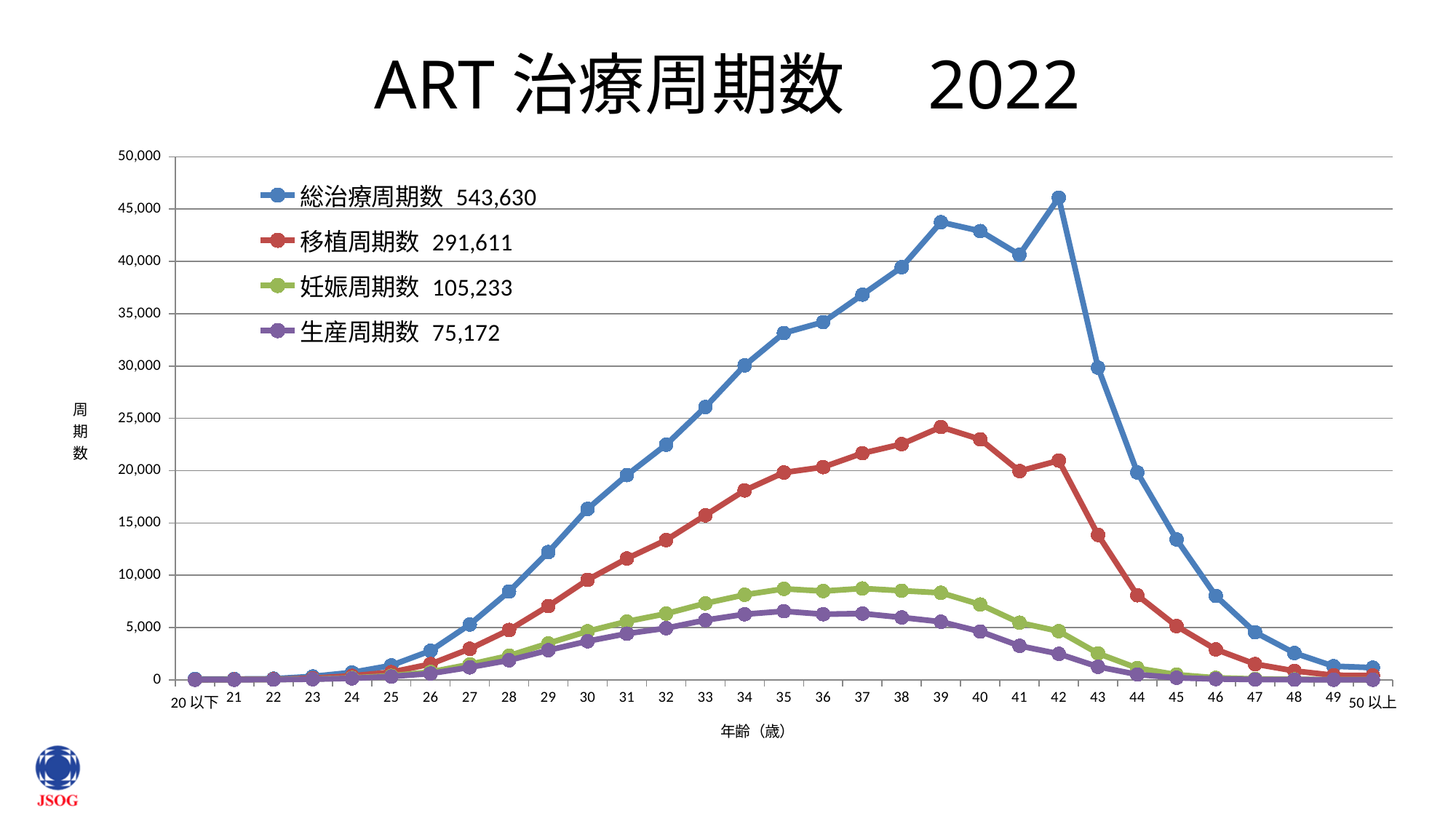
What total is shown in the legend for 生産周期数? 75,172 At which age does the 移植周期数 series reach its highest value? 39 What total is shown in the legend for 妊娠周期数? 105,233 At which age does the 総治療周期数 series reach its highest value? 42 How many series does the legend list? 4 Which series is larger at age 35, 総治療周期数 or 移植周期数? 総治療周期数 What total is shown in the legend for 移植周期数? 291,611 What total is shown in the legend for 総治療周期数? 543,630 What kind of chart is shown on the slide? line chart Is the value of 総治療周期数 at age 42 greater or less than 45,000? greater How many age categories are plotted along the x axis? 31 Is the value of 移植周期数 at age 39 greater or less than 25,000? less